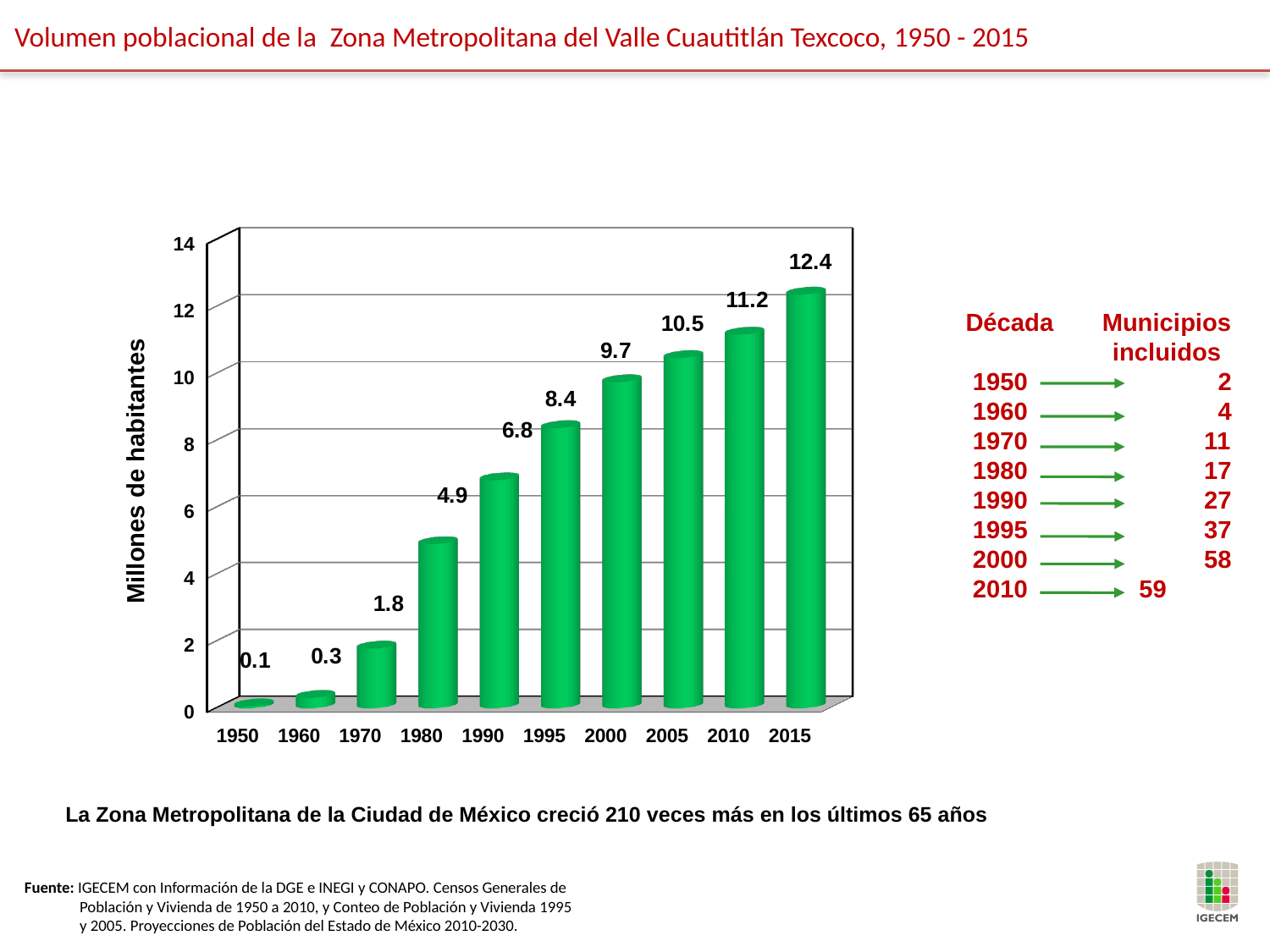
Which is larger, the value for 1995 or the value for 2005? 2005 Do the values rise or fall from 1950 to 2015? rise What is the label of the vertical axis? Millones de habitantes What is the difference between the values for 1990 and 1970? 5.0 Which year has the lowest value? 1950 Which year has the highest value? 2015 What is the value for 1980? 4.9 What is the value for 1950? 0.1 What is the difference between the values for 2015 and 2010? 1.2 How many years are shown on the x axis? 10 What is the value for 2000? 9.7 What kind of chart is shown? bar chart